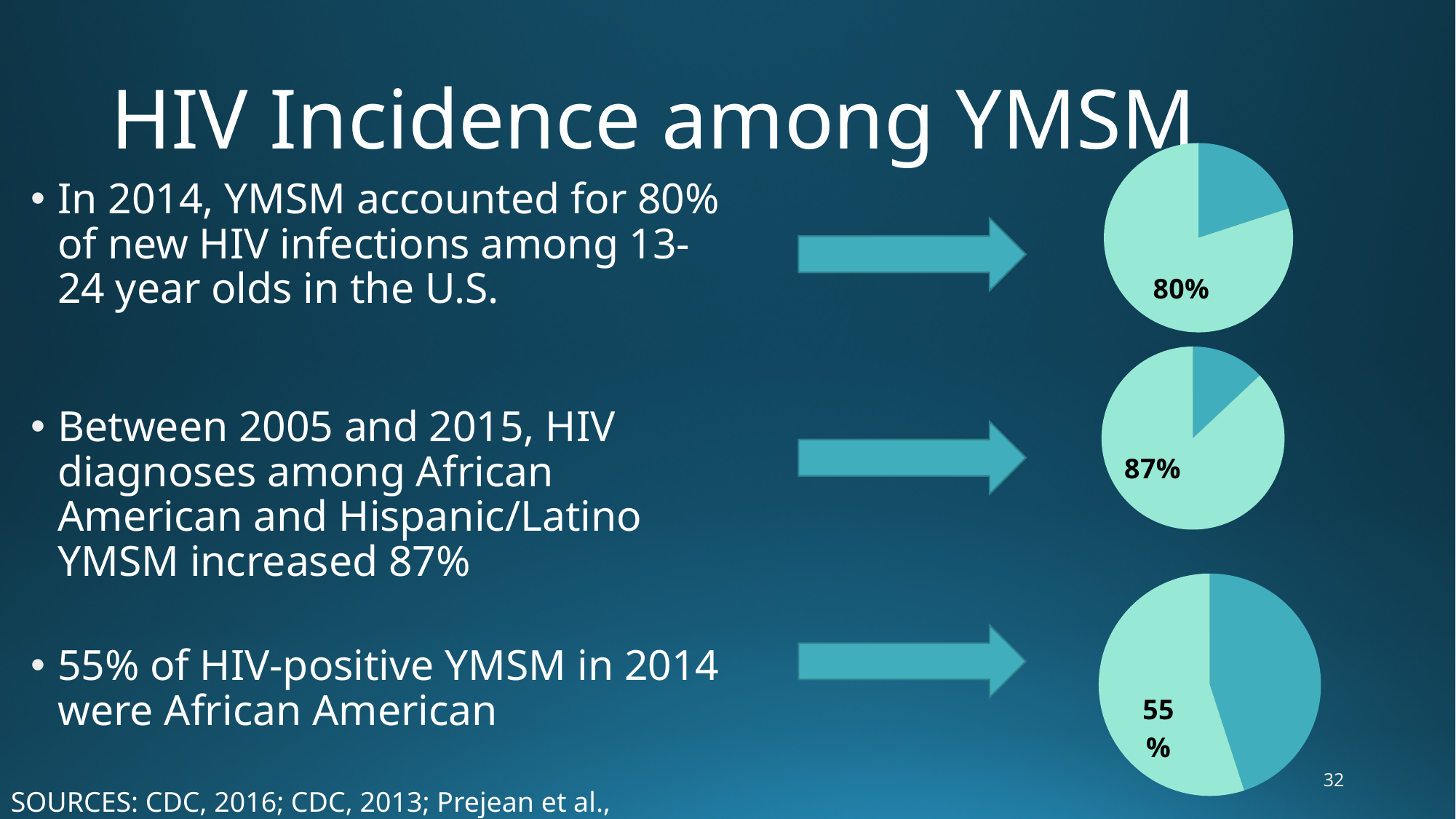
What value is labeled on the top pie chart? 80% Which of the three pie charts shows the smallest labeled value? the bottom pie chart (55%) What kind of chart is the top chart on the right side of the slide? pie chart In the bottom pie chart, is the labeled slice larger or smaller than the unlabeled slice? larger Which is larger, the value labeled on the top pie chart or the value labeled on the bottom pie chart? the top pie chart (80%) What value is labeled on the bottom pie chart? 55% How many slices does the bottom pie chart have? 2 Which of the three pie charts shows the largest labeled value? the middle pie chart (87%) What value is labeled on the middle pie chart? 87% What is the difference between the value labeled on the top pie chart and the value labeled on the bottom pie chart? 25% What is the difference between the value labeled on the middle pie chart and the value labeled on the top pie chart? 7% How many pie charts are shown on the slide? 3